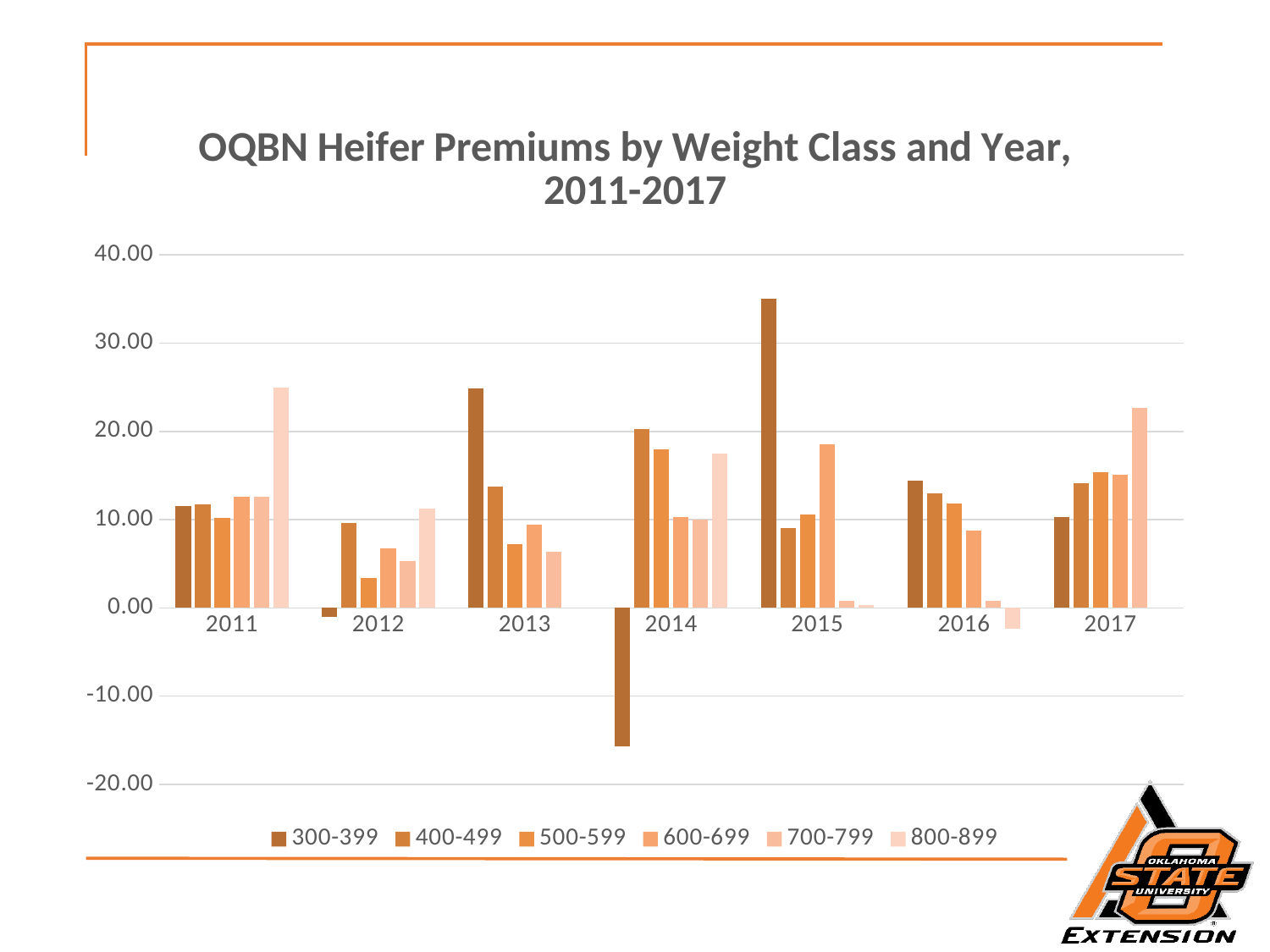
In 2011, which is larger: the 800-899 bar or the 300-399 bar? 800-899 In 2013, which is larger: the 300-399 bar or the 400-499 bar? 300-399 Is the value for 800-899 in 2011 greater or less than 20.00? greater Is the value for 300-399 in 2014 greater or less than -10.00? less In which year is the 300-399 bar the highest? 2015 Is the value for 300-399 in 2015 greater or less than 30.00? greater Which weight class has the highest bar in 2017? 700-799 How many years are shown along the x axis? 7 How many series does the legend list? 6 In which year is the 300-399 bar the lowest? 2014 What kind of chart is shown on the slide? bar chart What is the title of the chart? OQBN Heifer Premiums by Weight Class and Year, 2011-2017